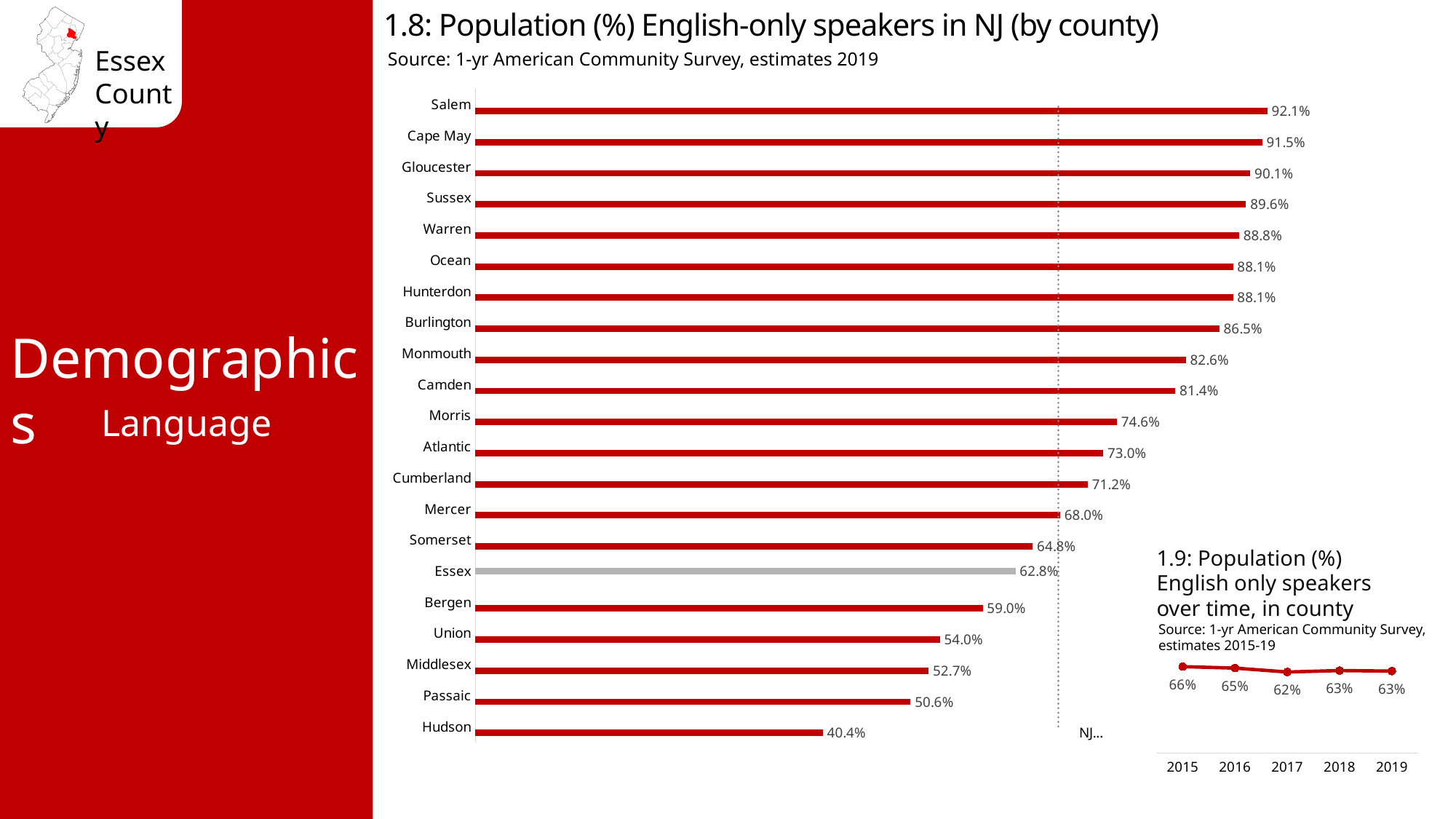
In chart 1.8, what is the value for Essex? 62.8% In chart 1.8, which county has the lowest percentage of English-only speakers? Hudson In chart 1.8, what is the difference between the values for Salem and Hudson? 51.7% In chart 1.9, what is the value for 2017? 62% In chart 1.8, how many counties are shown? 21 In chart 1.8, which bar is coloured grey instead of red? Essex In chart 1.9, what is the value for 2015? 66% In chart 1.8, which county has the highest percentage of English-only speakers? Salem In chart 1.9, how many years are plotted? 5 In chart 1.8, which is larger, the value for Bergen or the value for Union? Bergen What kind of chart is chart 1.8? bar chart In chart 1.8, what is the value for Hudson? 40.4%